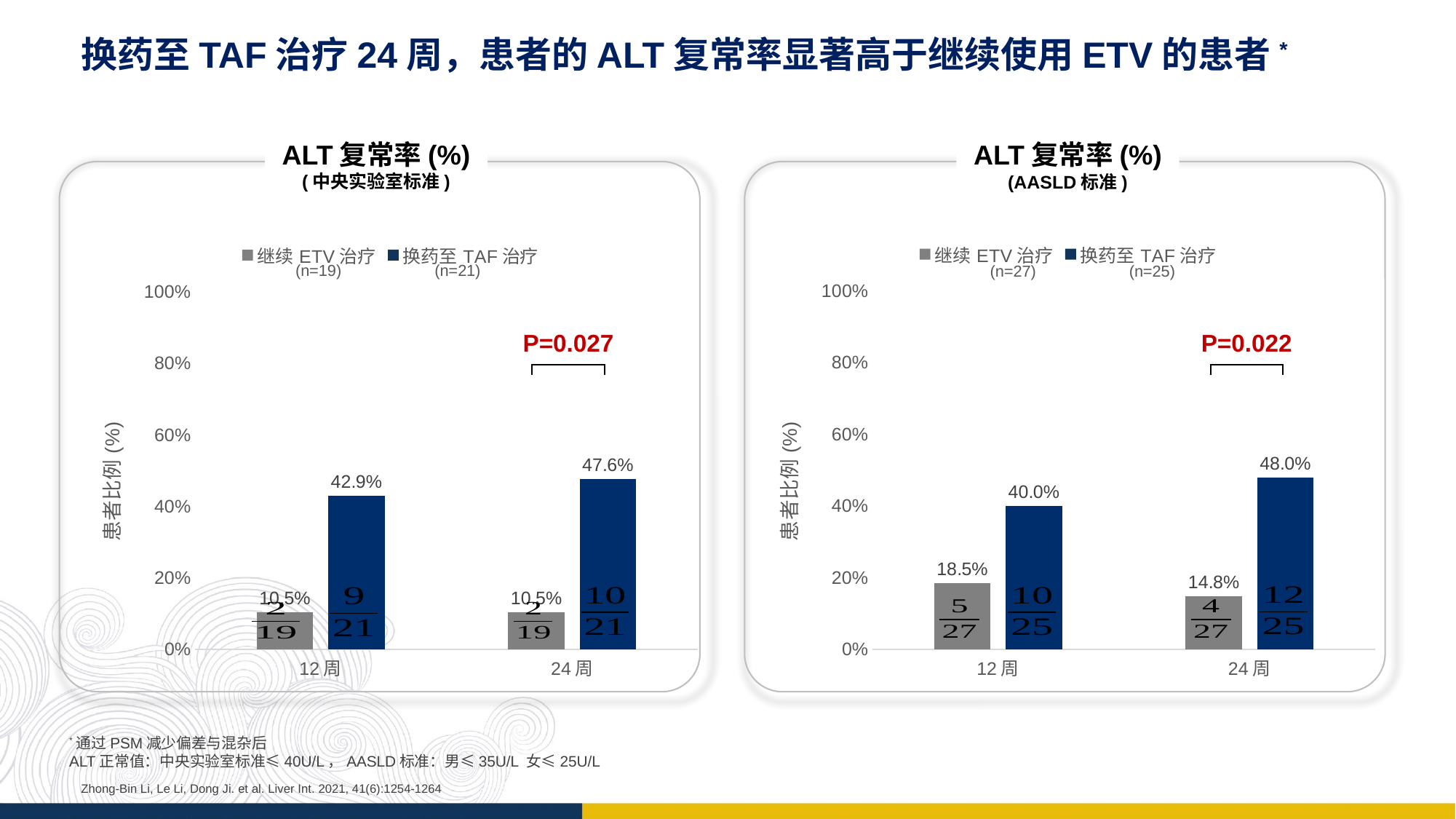
In the right chart (AASLD 标准), what is the value for 继续 ETV 治疗 at 24 周? 14.8% How many series does the legend of the left chart (中央实验室标准) list? 2 In the left chart (中央实验室标准), what is the value for 换药至 TAF 治疗 at 24 周? 47.6% In the right chart (AASLD 标准), which series has the higher value at 12 周, 继续 ETV 治疗 or 换药至 TAF 治疗? 换药至 TAF 治疗 In the right chart (AASLD 标准), which bar has the highest value? 换药至 TAF 治疗 at 24 周 In the right chart (AASLD 标准), what is the value for 换药至 TAF 治疗 at 12 周? 40.0% In the left chart (中央实验室标准), is the value for 换药至 TAF 治疗 at 24 周 greater or less than 40%? greater In the left chart (中央实验室标准), what is the value for 继续 ETV 治疗 at 12 周? 10.5% What kind of chart is the right chart (AASLD 标准)? Bar chart In the right chart (AASLD 标准), what P value is shown above the 24 周 bars? P=0.022 In the right chart (AASLD 标准), what is the difference between 换药至 TAF 治疗 and 继续 ETV 治疗 at 24 周? 33.2% In the left chart (中央实验室标准), what is the difference between 换药至 TAF 治疗 at 24 周 and at 12 周? 4.7%